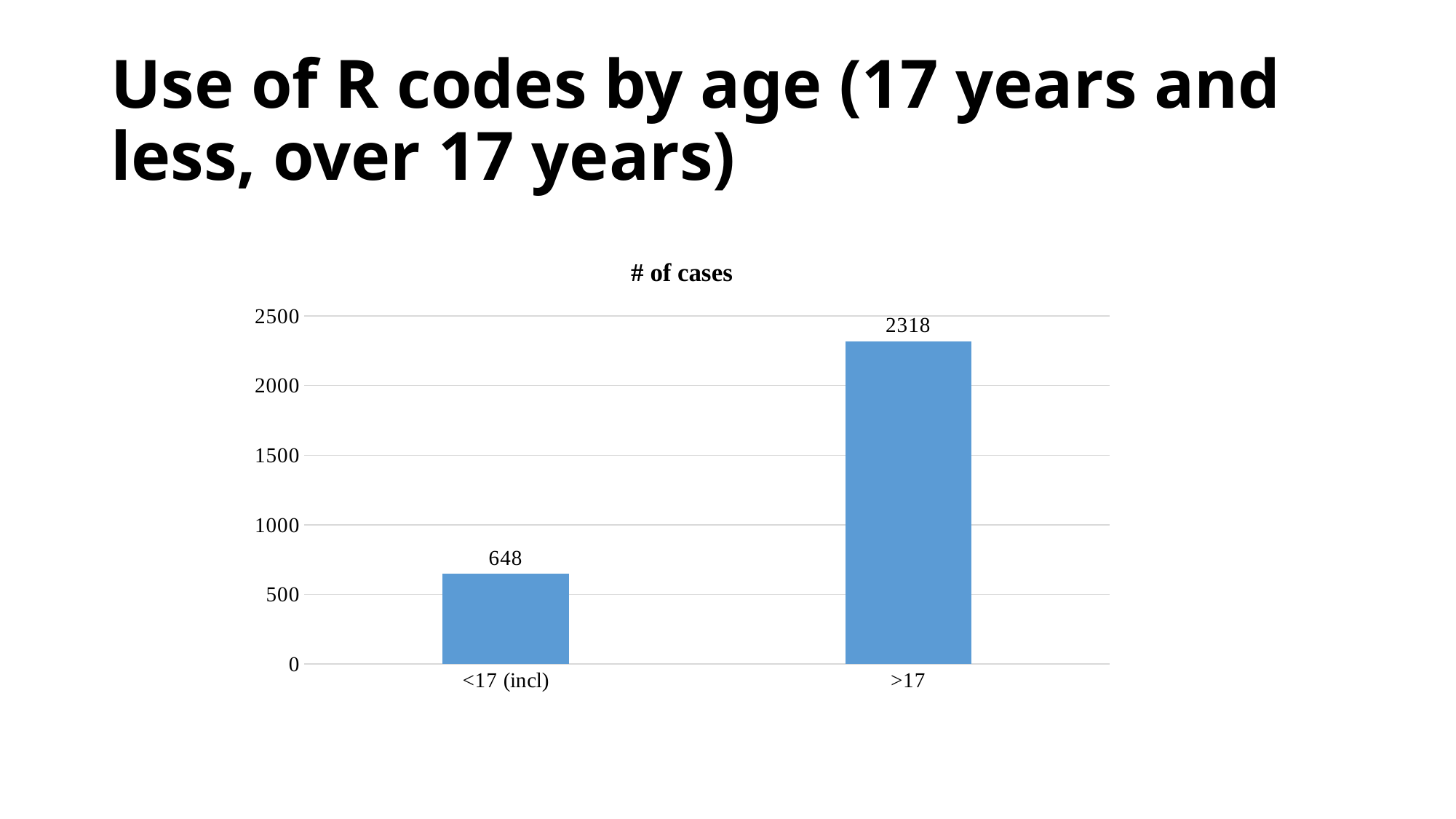
How many age categories are shown in the chart? 2 Is the value for <17 (incl) greater or less than 1000? less Is the value for >17 greater or less than 2000? greater What is the number of cases for the <17 (incl) age group? 648 What is the title of the chart? # of cases Which age group has the lowest number of cases? <17 (incl) What kind of chart is shown on the slide? Bar chart Which has more cases, the <17 (incl) group or the >17 group? >17 What is the difference in the number of cases between the >17 and <17 (incl) groups? 1670 What is the total number of cases across both age groups? 2966 What is the number of cases for the >17 age group? 2318 Which age group has the highest number of cases? >17